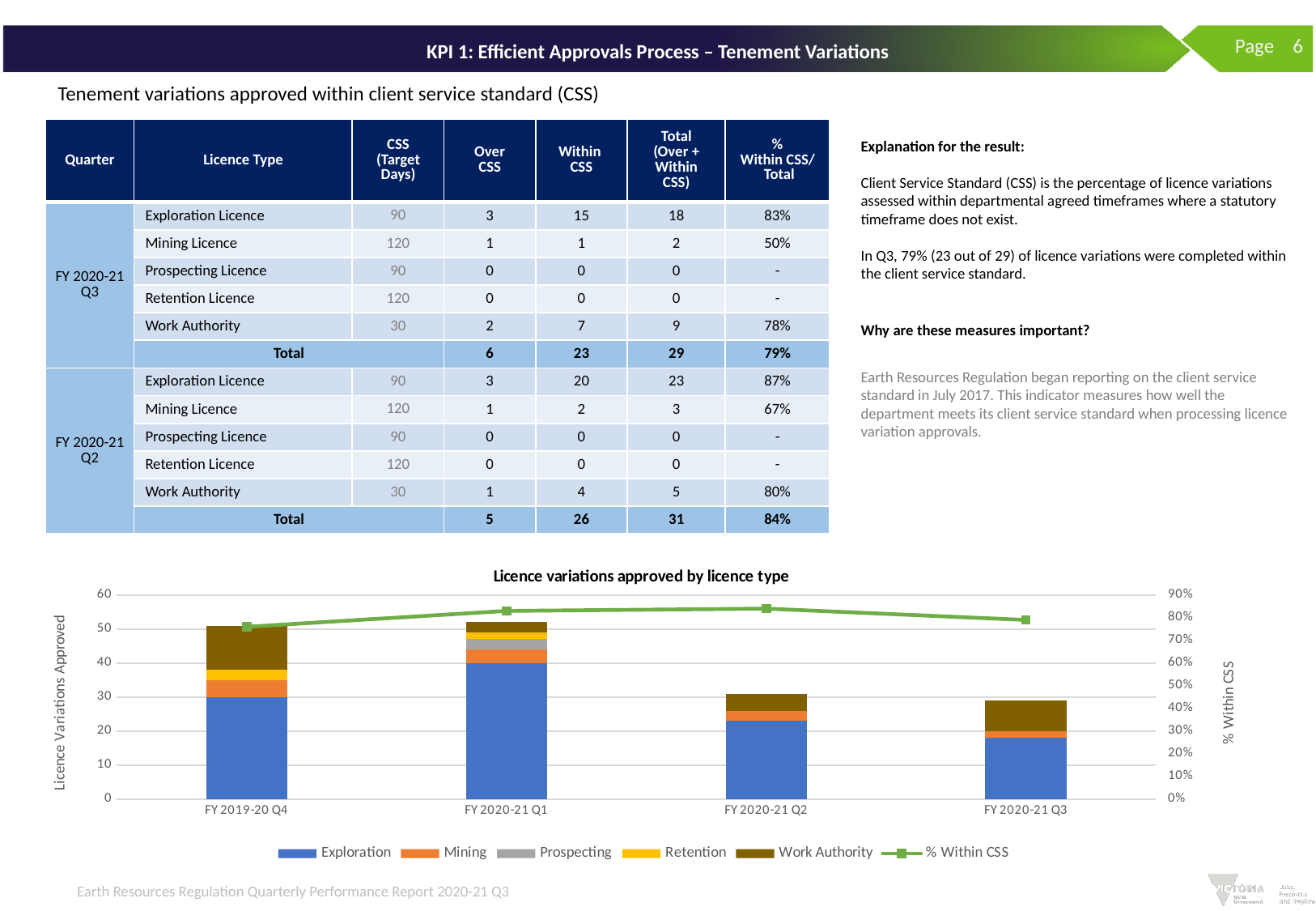
What kind of chart is shown on the slide? A stacked bar chart with a line series What is the title of the chart on the slide? Licence variations approved by licence type Is the total stacked bar for FY 2020-21 Q2 greater or less than 40? less Is the Exploration segment for FY 2020-21 Q1 greater or less than 30? greater Which has the taller stacked bar, FY 2020-21 Q1 or FY 2020-21 Q2? FY 2020-21 Q1 How many quarters are shown on the x axis of the chart? 4 Is the % Within CSS value for FY 2020-21 Q1 greater or less than 70%? greater How many series does the chart legend list? 6 Do the total stacked bars rise or fall from FY 2020-21 Q1 to FY 2020-21 Q3? fall Which series in the chart is plotted as a line rather than stacked bars? % Within CSS